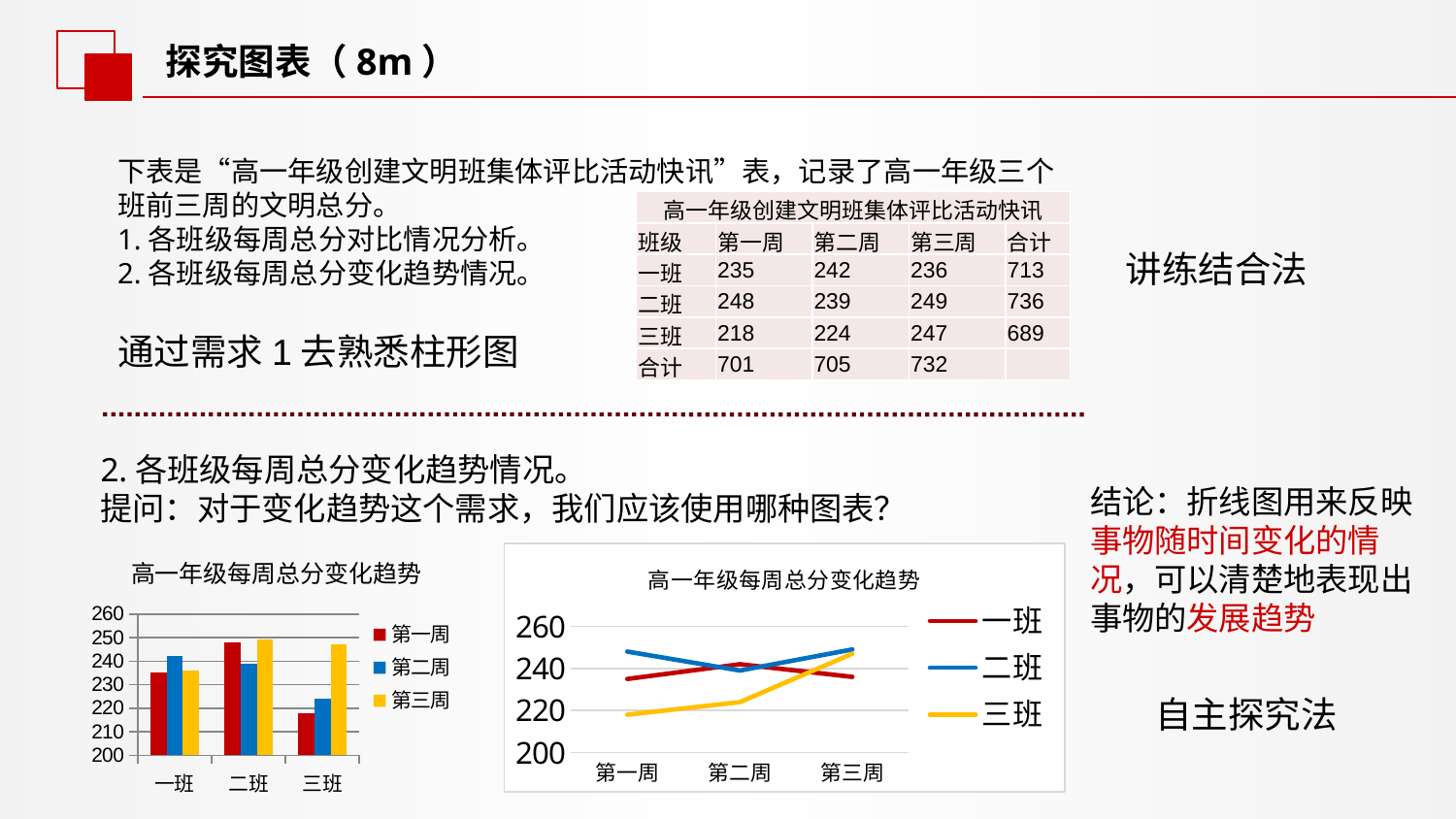
In the bar chart on the left, is the value for 二班 in 第三周 greater or less than 240? greater What kind of chart is the chart on the bottom right of the slide? line chart What is the title of the line chart on the right? 高一年级每周总分变化趋势 In the line chart on the right, which class has the highest value in 第一周? 二班 In the bar chart on the left, how many series does the legend list? 3 In the line chart on the right, which class has the lowest value in 第一周? 三班 In the bar chart on the left, is the value for 一班 in 第一周 greater or less than 240? less In the bar chart on the left, is the value for 三班 in 第二周 greater or less than 230? less In the line chart on the right, does the line for 三班 rise or fall from 第一周 to 第三周? rise In the line chart on the right, how many categories are shown on the x axis? 3 What kind of chart is the chart on the bottom left of the slide? bar chart In the bar chart on the left, which is larger for 第一周: 一班 or 三班? 一班